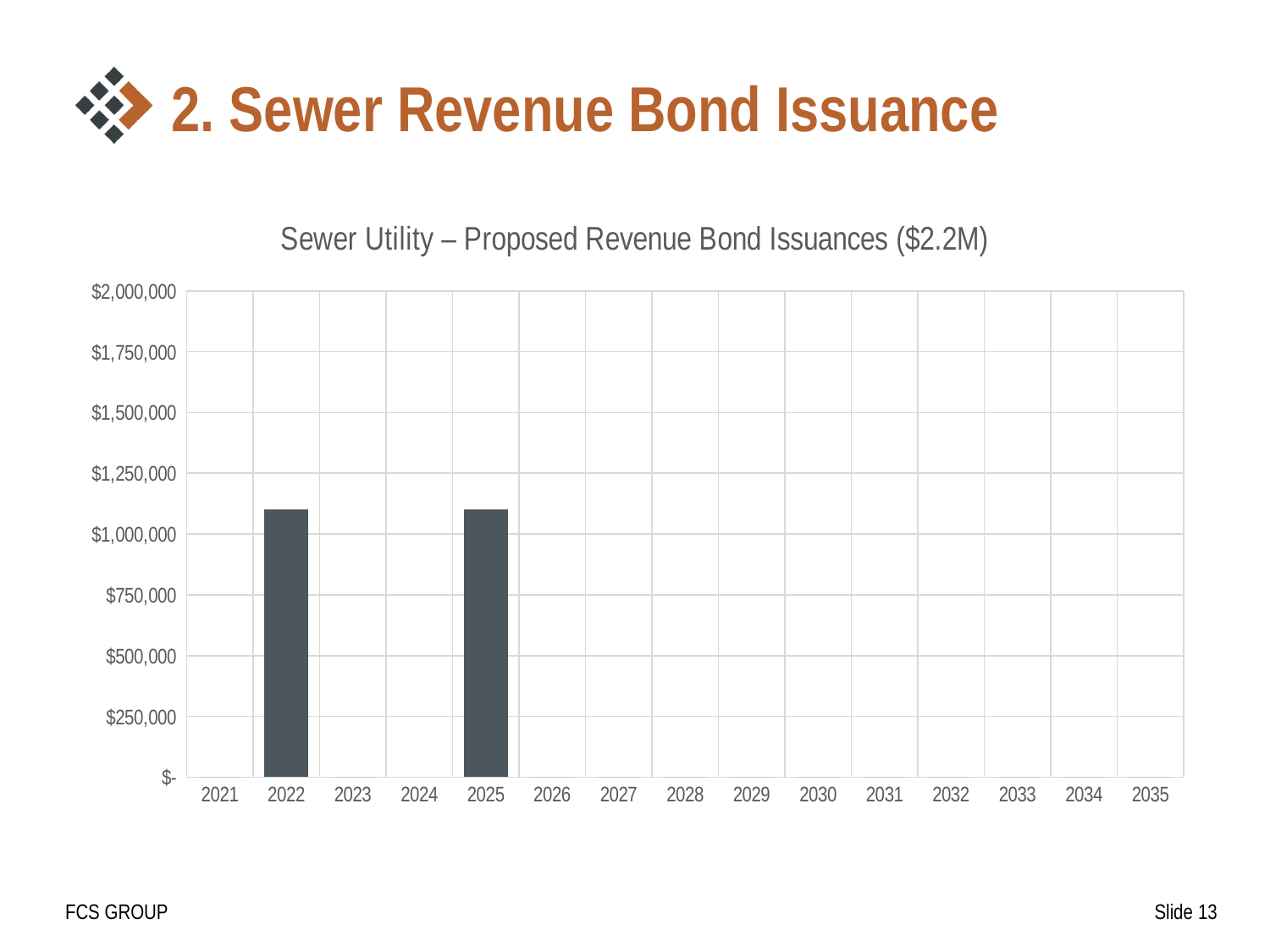
Is the value for 2022 greater or less than $1,250,000? less What is the title of the chart? Sewer Utility – Proposed Revenue Bond Issuances ($2.2M) How many years are shown along the x axis of the chart? 15 What is the first year shown on the x axis of the chart? 2021 In which years does the chart show a proposed revenue bond issuance? 2022 and 2025 What is the highest value labelled on the y axis of the chart? $2,000,000 How many years in the chart have a non-zero bar? 2 Is the value for 2025 greater or less than $1,000,000? greater What is the last year shown on the x axis of the chart? 2035 What kind of chart is shown on the slide? Bar chart Is the value for 2025 greater or less than $1,500,000? less